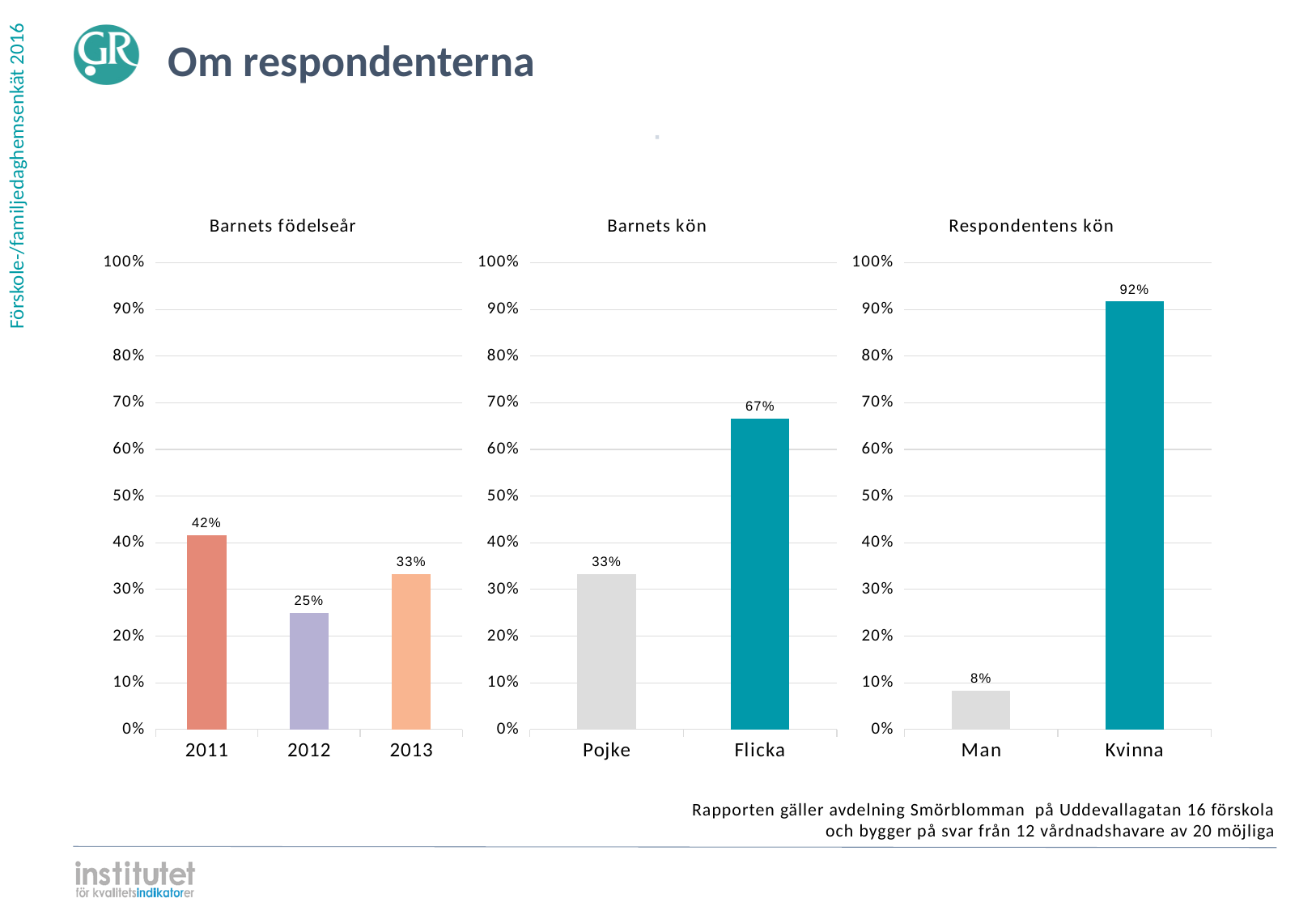
In the 'Barnets födelseår' chart, what is the value for 2011? 42% In the 'Barnets kön' chart, what is the value for Flicka? 67% In the 'Barnets kön' chart, what is the difference between Flicka and Pojke? 34% In the 'Barnets födelseår' chart, how many categories are shown on the x axis? 3 In the 'Respondentens kön' chart, is the value for Kvinna greater or less than 90%? greater In the 'Respondentens kön' chart, what is the value for Man? 8% In the 'Barnets kön' chart, which is larger, Pojke or Flicka? Flicka In the 'Barnets födelseår' chart, which birth year has the lowest value? 2012 What kind of chart is the 'Barnets kön' chart? Bar chart In the 'Respondentens kön' chart, which category has the highest value? Kvinna What is the title of the chart on the left of the slide? Barnets födelseår In the 'Barnets födelseår' chart, what is the difference between the values for 2011 and 2013? 9%